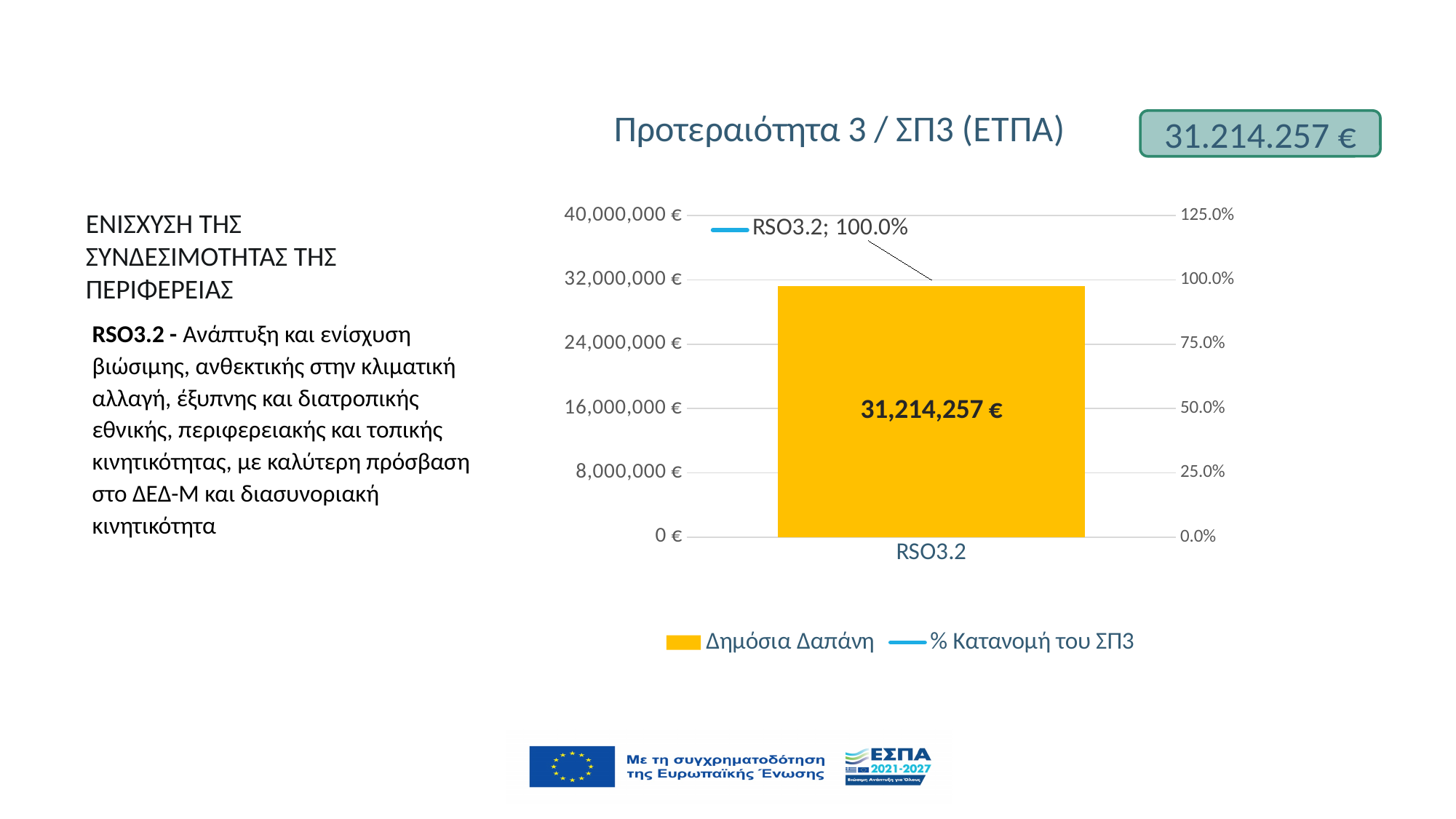
What is the highest value shown on the left (euro) axis of the chart? 40,000,000 € What kind of chart is shown on the slide? bar chart Is the Δημόσια Δαπάνη value for RSO3.2 greater or less than 24,000,000 €? greater What is the title of the chart? Προτεραιότητα 3 / ΣΠ3 (ΕΤΠΑ) What is the highest value shown on the right (percentage) axis of the chart? 125.0% What is the Δημόσια Δαπάνη value for RSO3.2? 31,214,257 € What is the % Κατανομή του ΣΠ3 value for RSO3.2? 100.0% How many series does the chart legend list? 2 Is the Δημόσια Δαπάνη value for RSO3.2 greater or less than 32,000,000 €? less How many categories are shown on the x axis of the chart? 1 What colour is the Δημόσια Δαπάνη bar in the chart? yellow What is the label of the single category on the x axis? RSO3.2